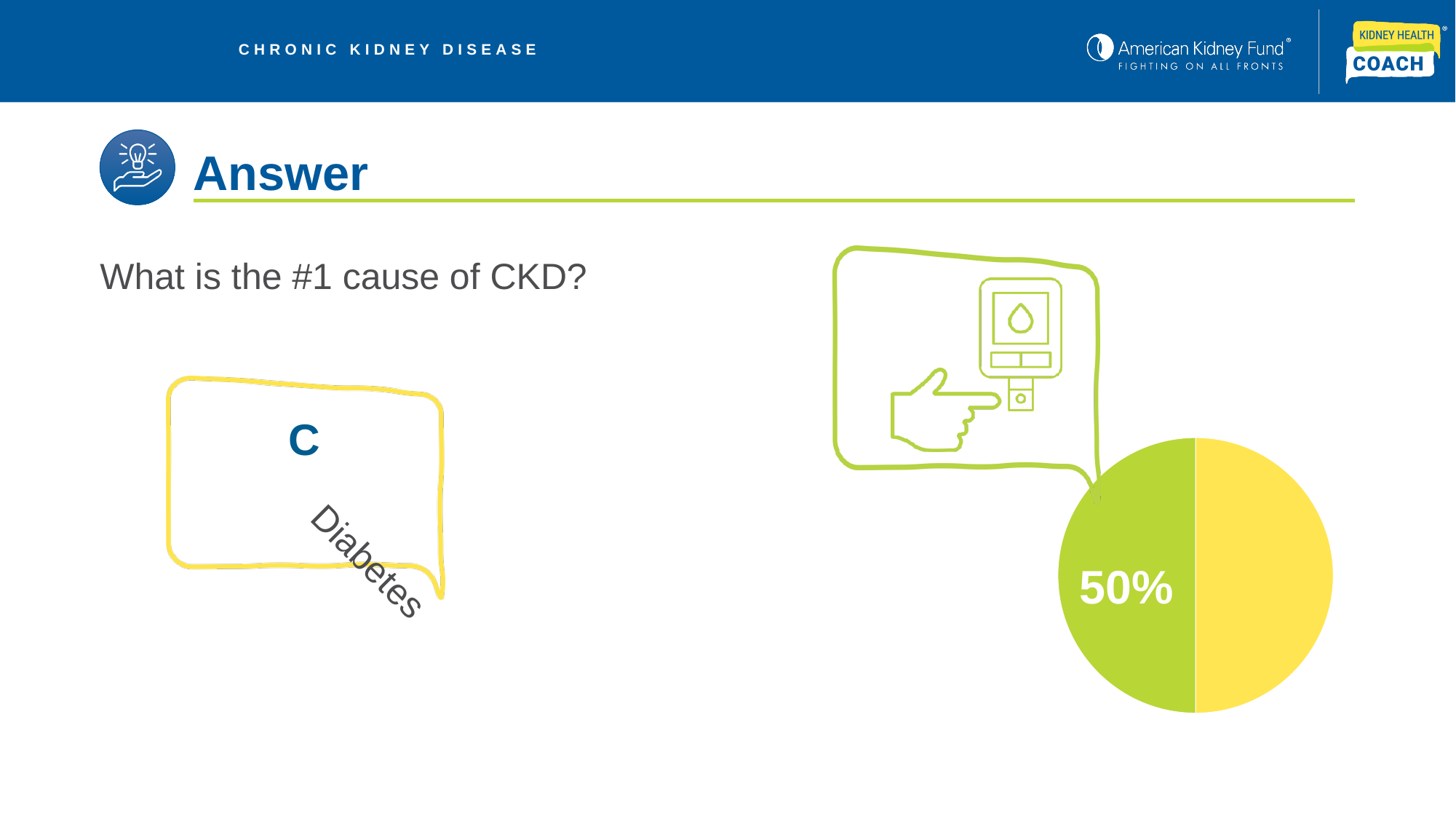
What two colours are used for the slices of the pie chart? green and yellow How many slices does the pie chart have? 2 What share of the pie does the labelled green slice represent? 50% Which slice of the pie chart carries a data label, the green one or the yellow one? the green one What kind of chart is shown on the slide? pie chart What value is printed on the green slice of the pie chart? 50%